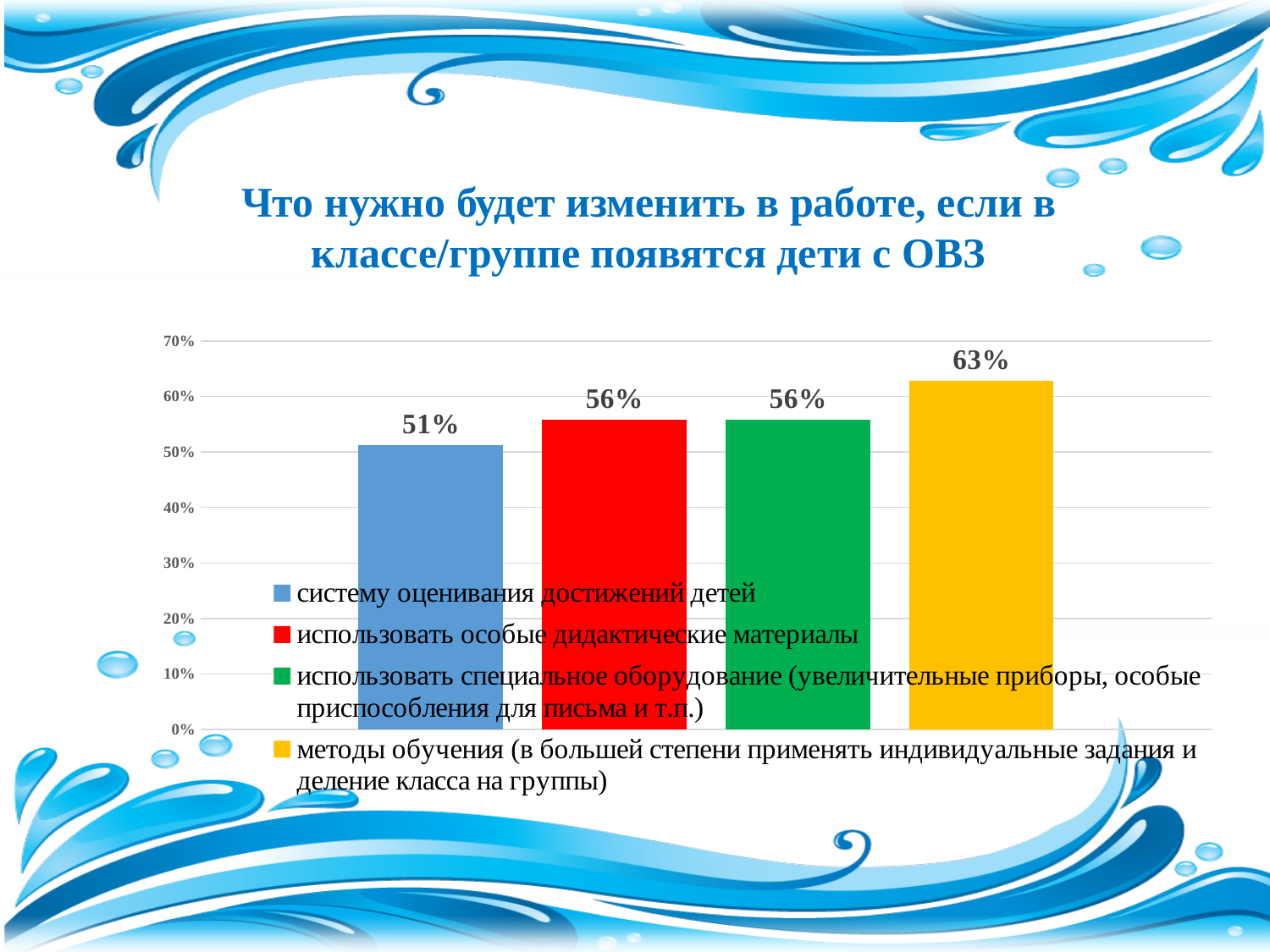
What is the value for "методы обучения (в большей степени применять индивидуальные задания и деление класса на группы)"? 63% What is the difference between the value for "методы обучения" and the value for "систему оценивания достижений детей"? 12% What is the value for "использовать специальное оборудование (увеличительные приборы, особые приспособления для письма и т.п.)"? 56% What colour is the bar for "использовать особые дидактические материалы"? Red What type of chart is shown on the slide? Bar chart What is the value for "систему оценивания достижений детей"? 51% What is the value for "использовать особые дидактические материалы"? 56% Which legend entry has the highest value? методы обучения (в большей степени применять индивидуальные задания и деление класса на группы) Which is larger: the value for "использовать особые дидактические материалы" or the value for "систему оценивания достижений детей"? использовать особые дидактические материалы How many entries does the legend list? 4 Which legend entry has the lowest value? систему оценивания достижений детей How many bars are plotted in the chart? 4